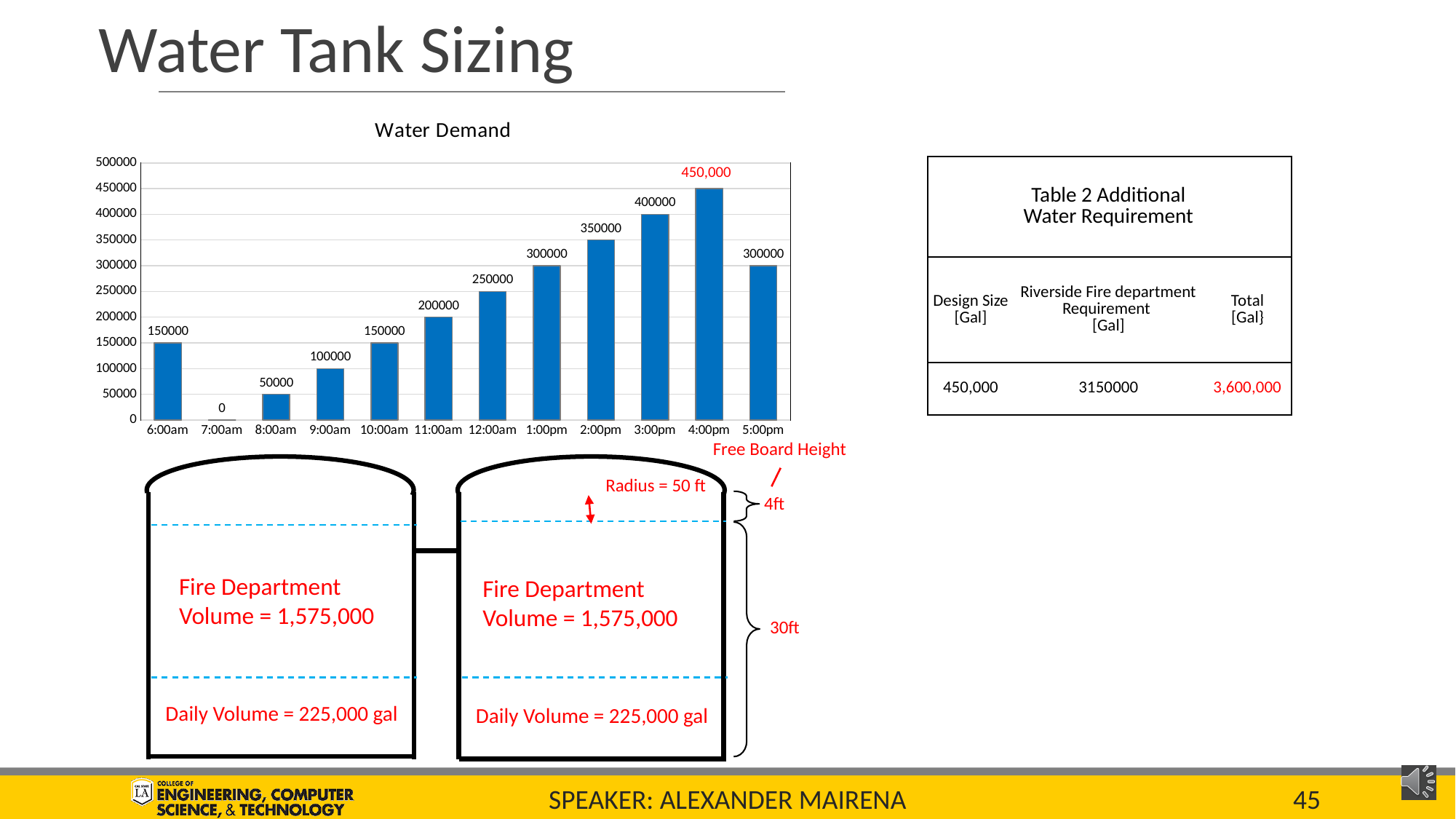
What is the water demand value at 5:00pm? 300000 What is the water demand value at 11:00am? 200000 Which is larger, the water demand at 6:00am or at 8:00am? 6:00am What is the water demand value at 2:00pm? 350000 Which time has the highest water demand? 4:00pm What kind of chart is the Water Demand chart? bar chart Which time has the lowest water demand? 7:00am How many time categories are shown on the x axis of the Water Demand chart? 12 What is the difference between the water demand at 3:00pm and at 9:00am? 300000 What is the title of the chart? Water Demand Do the water demand values rise or fall from 7:00am to 4:00pm? rise What is the maximum value shown on the y axis of the Water Demand chart? 500000